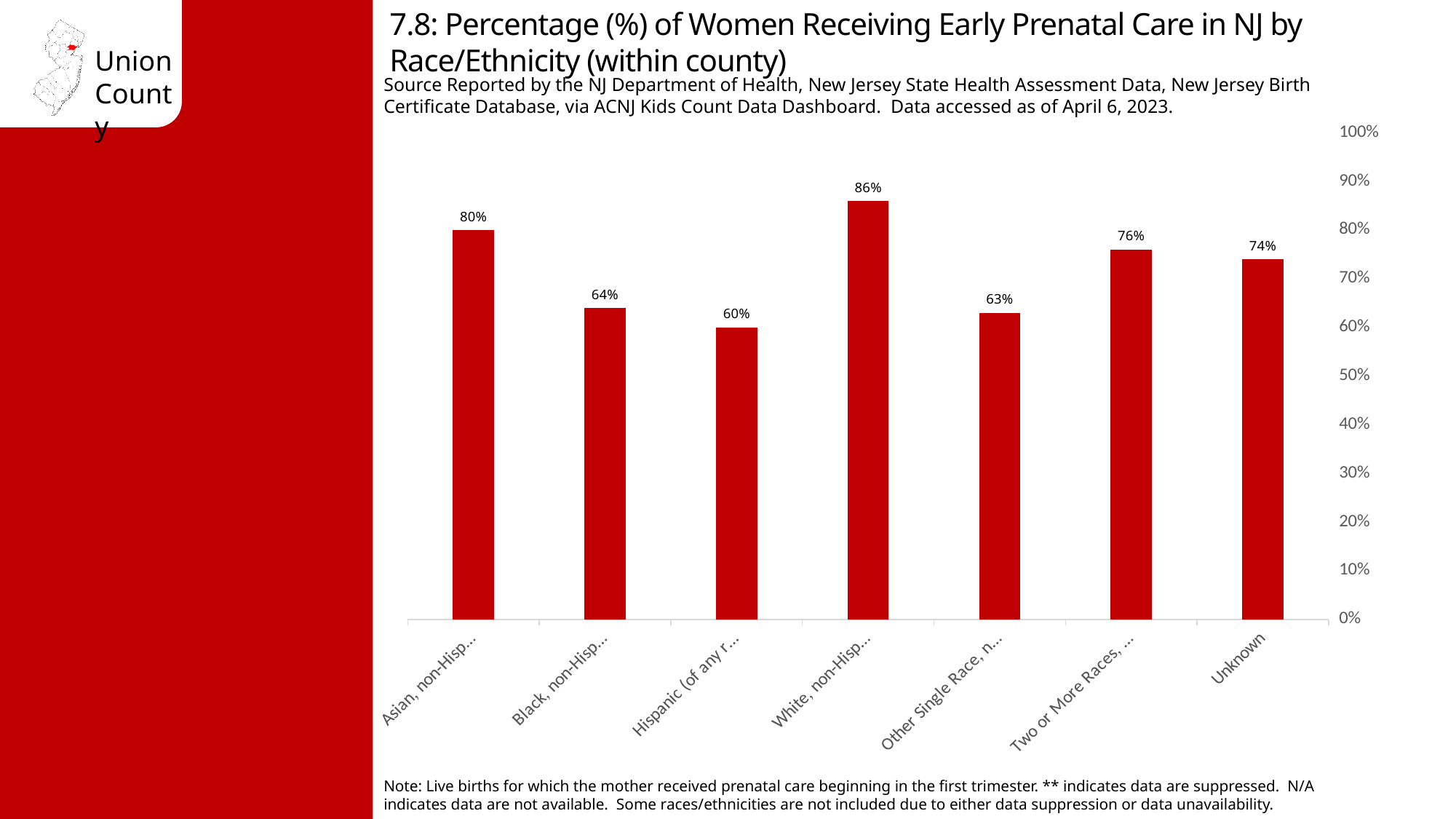
What is the value shown for the Hispanic (of any race) category? 60% What is the maximum value shown on the vertical axis? 100% What is the value for the Two or More Races category? 76% What type of chart is shown on the slide? Bar chart What is the difference between the White, non-Hispanic value and the Black, non-Hispanic value? 22% Which race/ethnicity category has the highest percentage of women receiving early prenatal care? White, non-Hispanic How many race/ethnicity categories are plotted on the chart? 7 Which is larger: the value for Other Single Race or the value for Black, non-Hispanic? Black, non-Hispanic What percentage is shown for the Unknown category? 74% Is the value for the Unknown category greater or less than 70%? greater What percentage of women in the Asian, non-Hispanic category received early prenatal care? 80% Which race/ethnicity category has the lowest percentage? Hispanic (of any race)